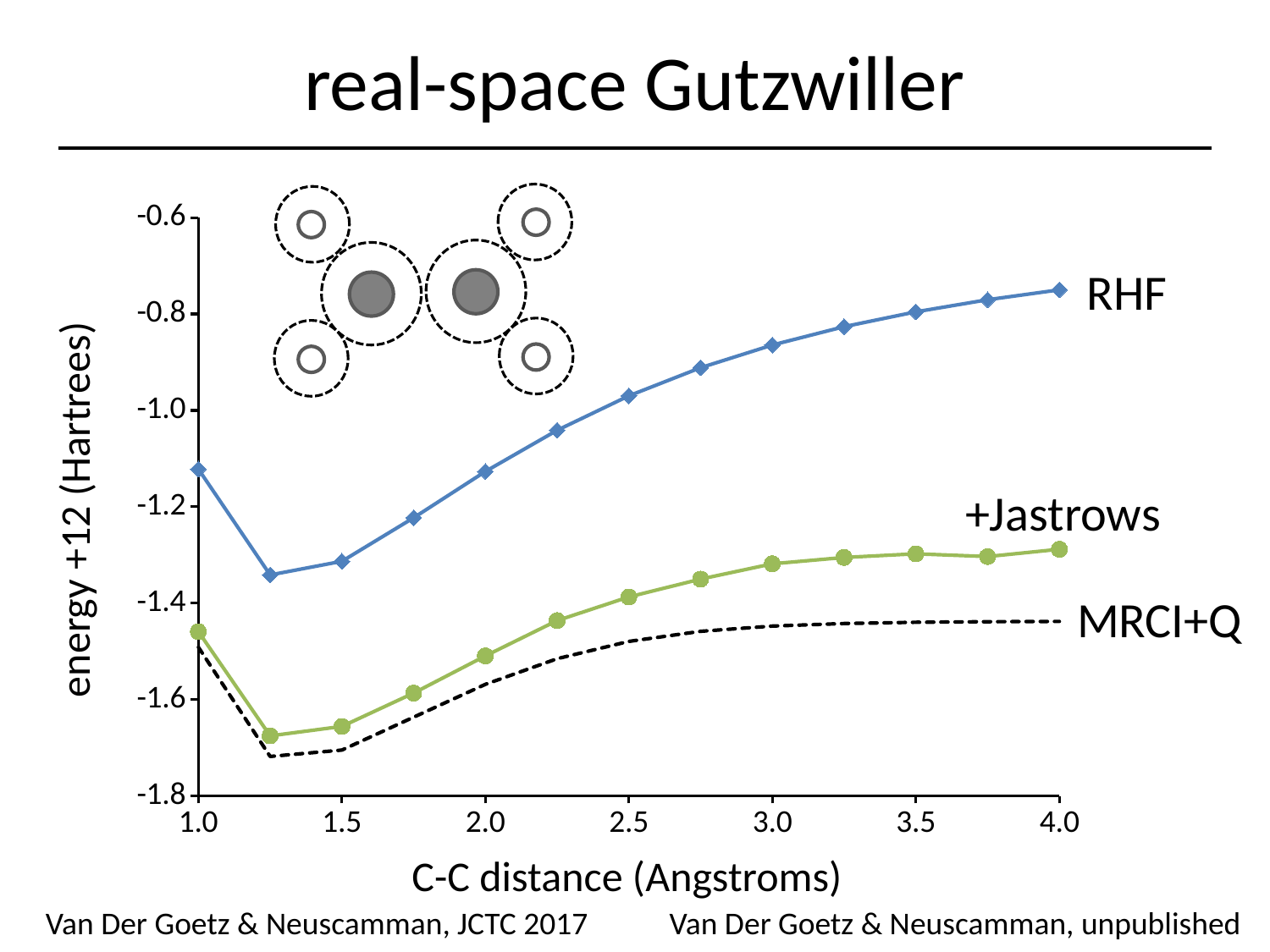
Is the +Jastrows energy at a C-C distance of 1.25 Angstroms greater or less than -1.6? less At a C-C distance of 4.0 Angstroms, which series has the higher energy, RHF or +Jastrows? RHF How many data points are plotted for the RHF series? 13 Is the RHF energy at a C-C distance of 1.0 Angstroms greater or less than -1.2? greater What is the label of the x axis? C-C distance (Angstroms) Does the RHF energy rise or fall as the C-C distance increases from 1.5 to 4.0 Angstroms? rise At which C-C distance does the RHF series reach its highest energy? 4.0 Which series is drawn as a black dashed line? MRCI+Q How many data series are plotted on the chart? 3 What kind of chart is shown on the slide? line chart At which C-C distance does the RHF series reach its lowest energy? 1.25 Is the +Jastrows energy at a C-C distance of 4.0 Angstroms greater or less than -1.4? greater